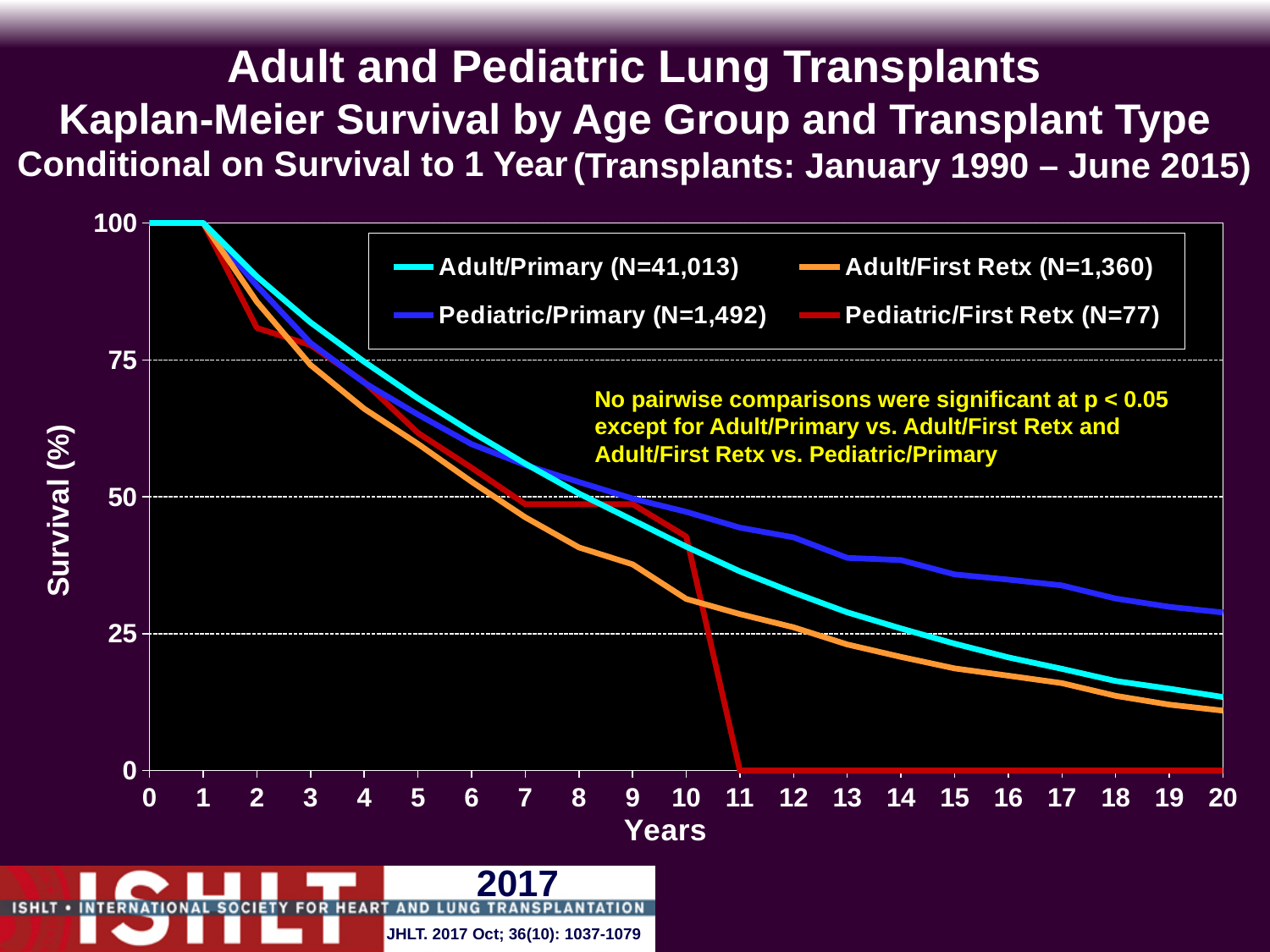
How many series does the legend list? 4 Is the value for Adult/First Retx at year 20 greater or less than 25? less At year 20, which series has the higher survival: Pediatric/Primary or Adult/Primary? Pediatric/Primary Is the value for Adult/Primary at year 5 greater or less than 50? greater Which series has the highest survival at year 20? Pediatric/Primary Is the value for Adult/Primary at year 10 greater or less than 50? less Do the survival values rise or fall as years increase? fall What kind of chart is shown on the slide? line chart What is the survival value for Adult/Primary at year 1? 100 What is the survival value for Pediatric/First Retx at year 15? 0 What is the N shown in the legend for Adult/Primary? 41,013